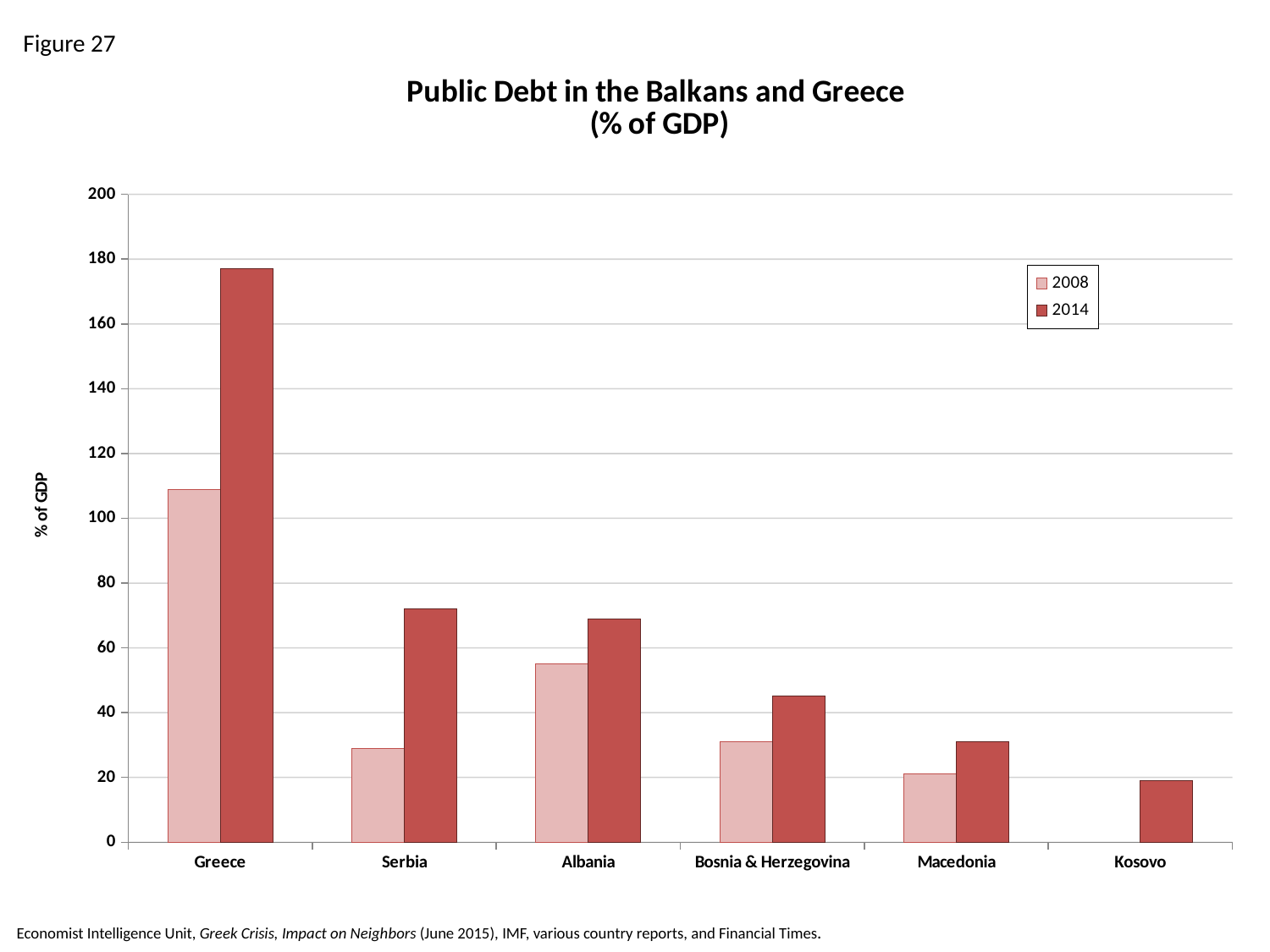
Which country has the highest public debt in 2014? Greece Is the 2008 value for Greece greater or less than 100? greater Is the 2008 value for Albania greater or less than 60? less What is the label on the y axis? % of GDP How many series does the legend list? 2 How many countries are shown on the x axis? 6 Which country has the highest public debt in 2008? Greece What kind of chart is shown on the slide? bar chart Is the 2014 value for Greece greater or less than 160? greater Which country has the lowest public debt in 2014? Kosovo Which is larger, the 2008 value for Albania or the 2008 value for Serbia? Albania